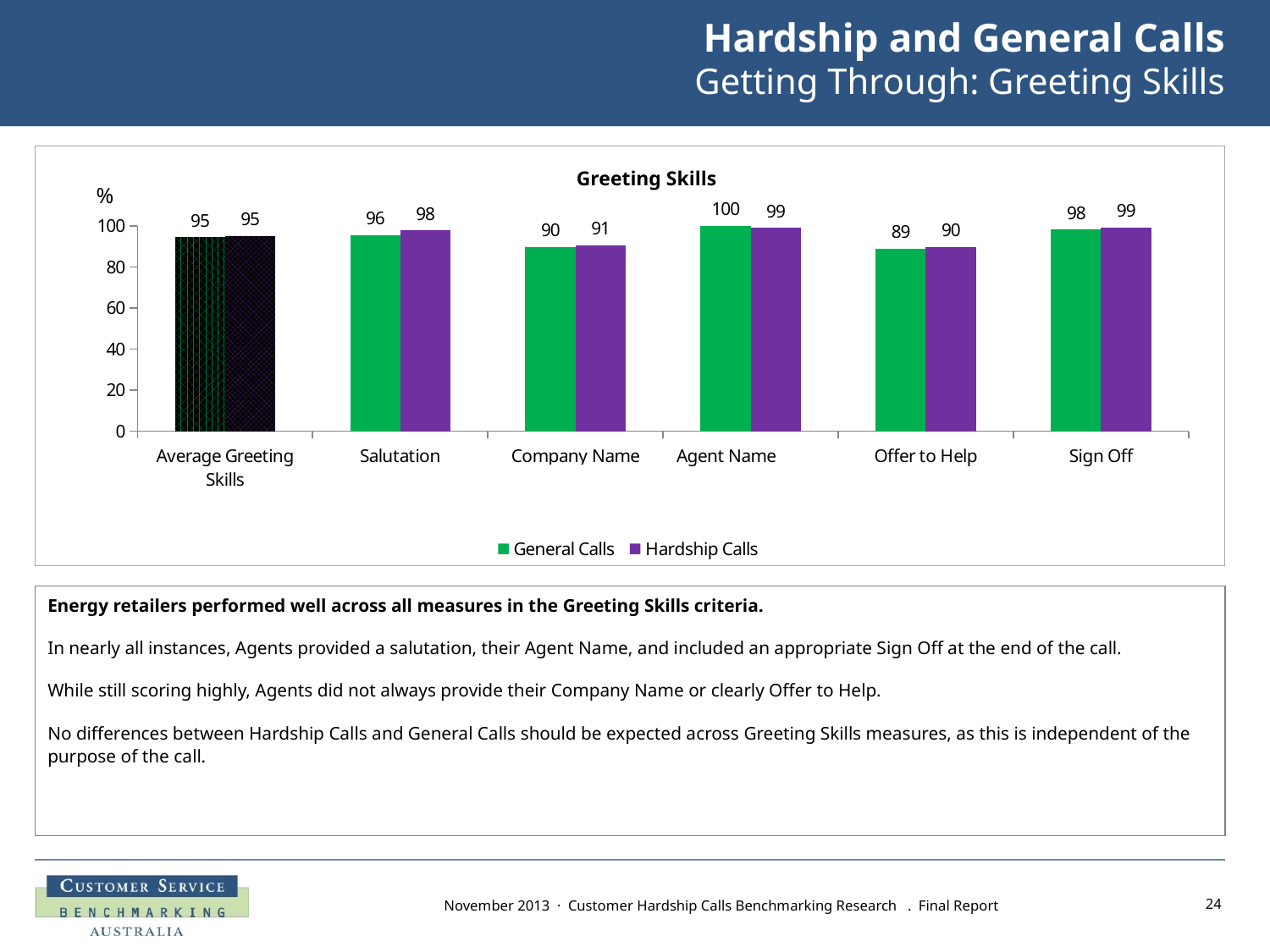
What is the difference between the Hardship Calls and General Calls values for Salutation? 2 Which category has the highest General Calls value? Agent Name What is the title of the chart? Greeting Skills How many categories are shown on the x axis? 6 What is the Hardship Calls value for Offer to Help? 90 Which is larger for Company Name: General Calls or Hardship Calls? Hardship Calls Which category has the lowest General Calls value? Offer to Help What kind of chart is shown? Bar chart What is the Hardship Calls value for Salutation? 98 How many series does the legend list? 2 What is the Average Greeting Skills value for General Calls? 95 What is the General Calls value for Agent Name? 100